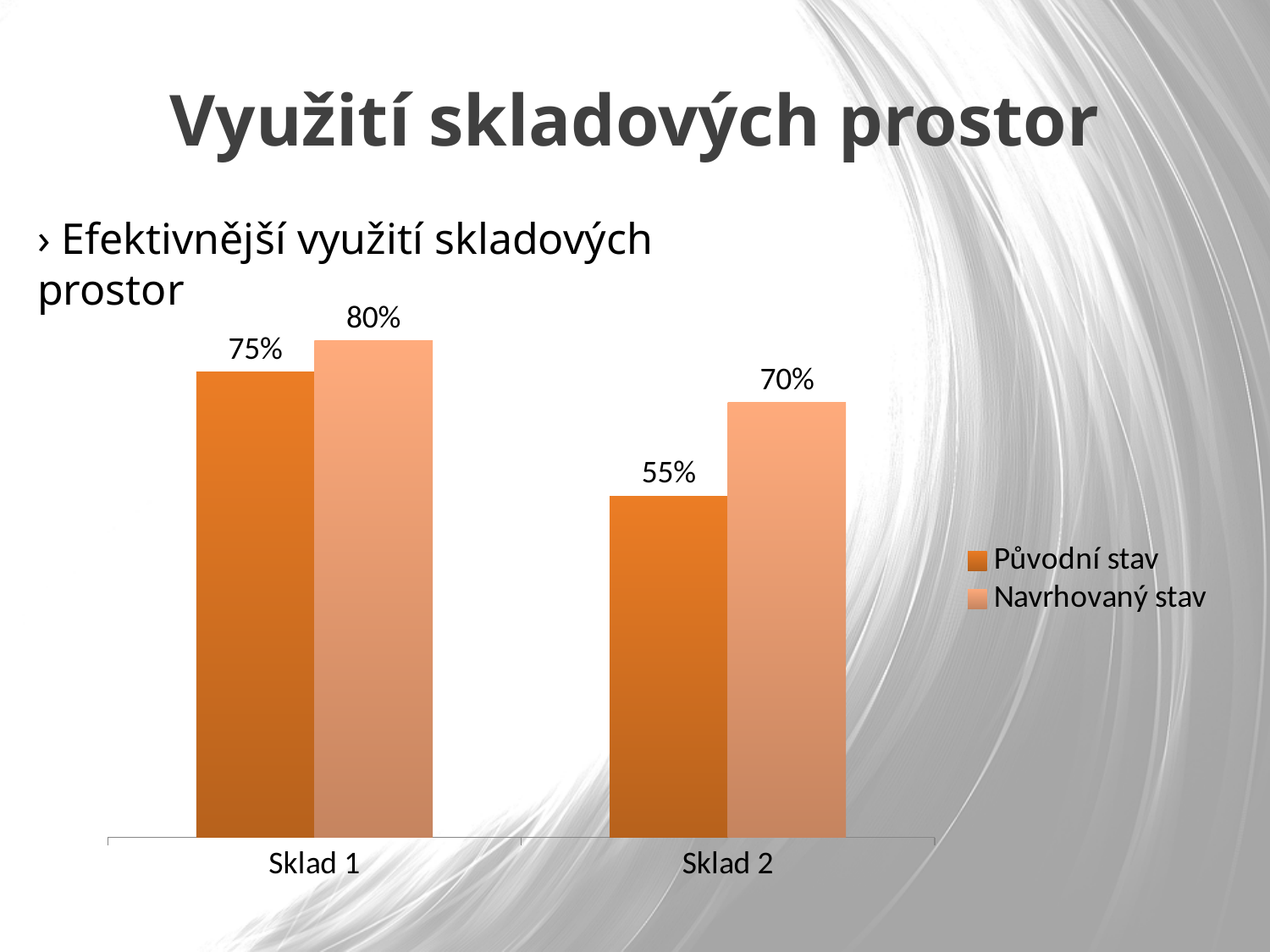
How many series does the legend list? 2 What is the difference between the Navrhovaný stav and Původní stav values for Sklad 1? 5% What is the value for Sklad 2 in the Navrhovaný stav series? 70% Which category has the highest value in the Navrhovaný stav series? Sklad 1 Which category has the lowest value in the Původní stav series? Sklad 2 What is the value for Sklad 1 in the Původní stav series? 75% What is the value for Sklad 2 in the Původní stav series? 55% How many categories are shown on the x axis? 2 What kind of chart is shown on the slide? Bar chart What is the value for Sklad 1 in the Navrhovaný stav series? 80% What is the difference between the Navrhovaný stav and Původní stav values for Sklad 2? 15% Which is larger: the Původní stav value for Sklad 1 or the Navrhovaný stav value for Sklad 2? Původní stav value for Sklad 1